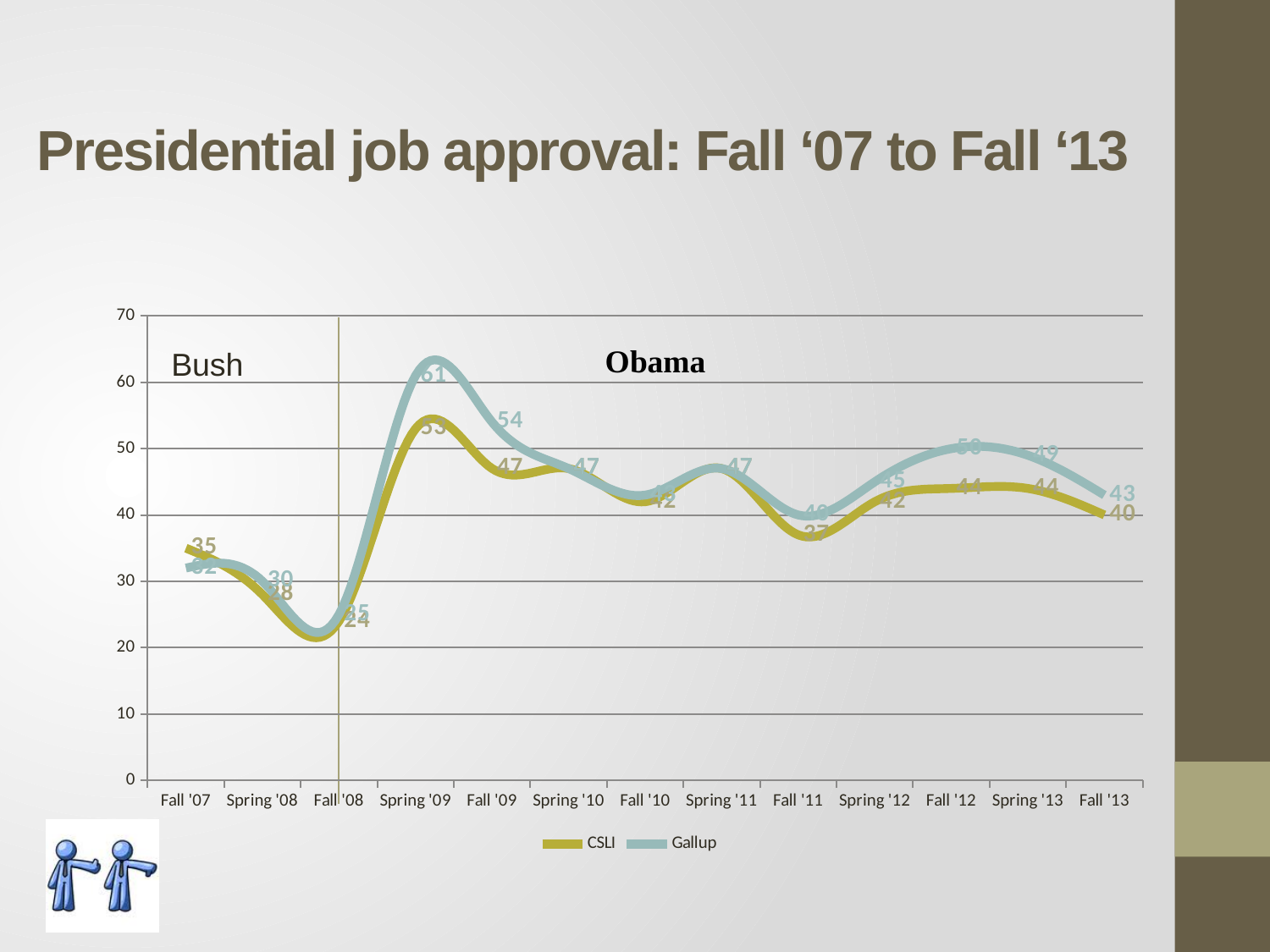
At which time point do both series reach their lowest value? Fall '08 How many series does the legend list? 2 What is the CSLI approval value for Fall '13? 40 What is the difference between the Gallup and CSLI values for Fall '13? 3 What kind of chart is shown on the slide? line chart At which time point does the Gallup series reach its highest value? Spring '09 What is the Gallup approval value for Fall '09? 54 How many time points are plotted along the x axis? 13 What is the CSLI approval value for Fall '11? 37 What is the Gallup approval value for Fall '13? 43 Which two series names appear in the legend? CSLI and Gallup Is the Gallup value for Spring '09 greater or less than 60? greater